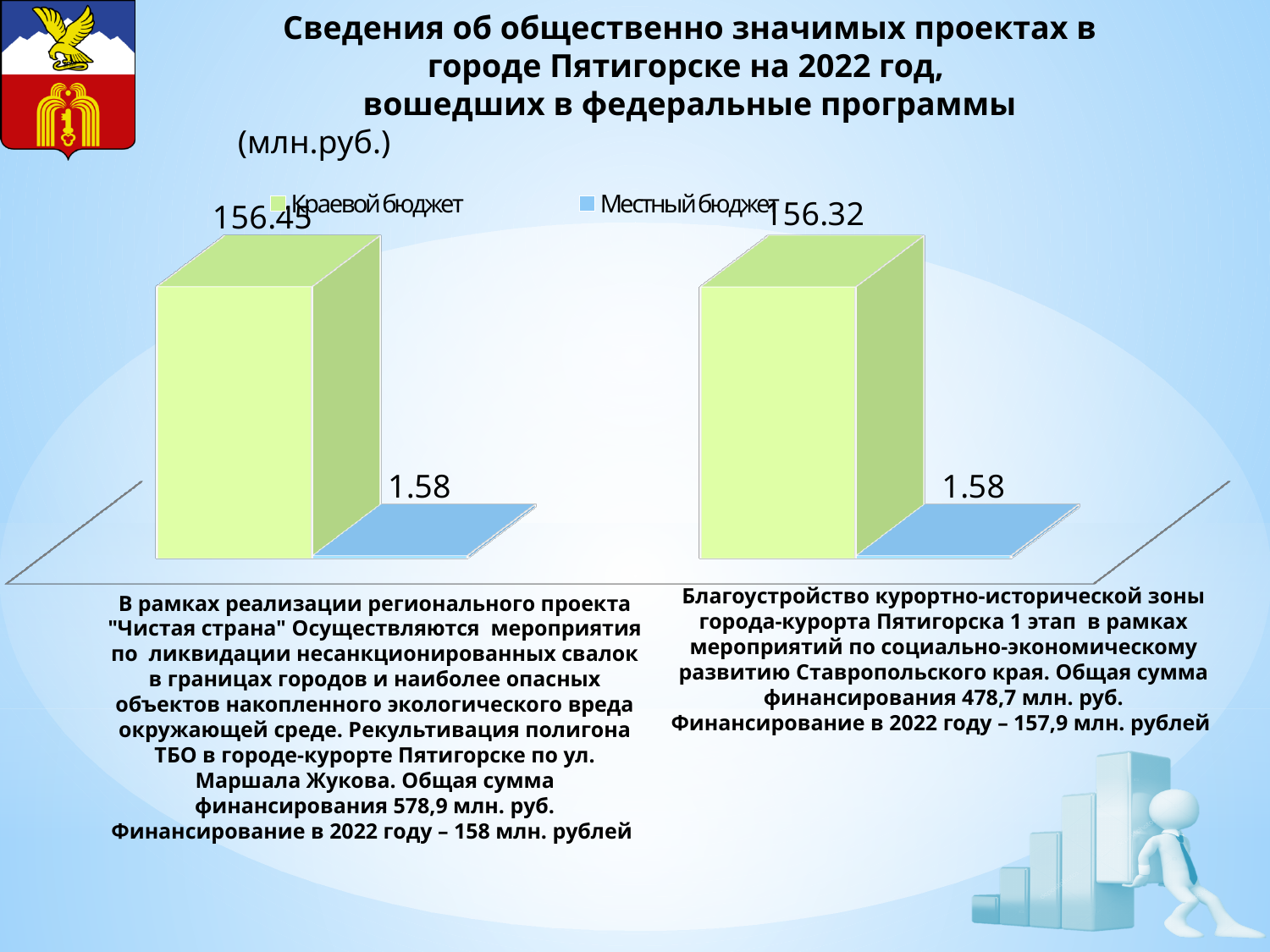
How many project categories are plotted on the chart? 2 What is the difference between Краевой бюджет and Местный бюджет for the left project ("Чистая страна")? 154.87 What is the difference between Краевой бюджет and Местный бюджет for the right project (Благоустройство курортно-исторической зоны)? 154.74 What is the value of Местный бюджет for the right project (Благоустройство курортно-исторической зоны)? 1.58 Which series has the larger value for the left project: Краевой бюджет or Местный бюджет? Краевой бюджет What is the difference between the Краевой бюджет values of the left and right projects? 0.13 What kind of chart is shown on the slide? bar chart What is the value of Краевой бюджет for the left project ("Чистая страна")? 156.45 What is the value of Местный бюджет for the left project ("Чистая страна")? 1.58 What is the value of Краевой бюджет for the right project (Благоустройство курортно-исторической зоны)? 156.32 How many series does the chart legend list? 2 What are the two series named in the chart legend? Краевой бюджет and Местный бюджет